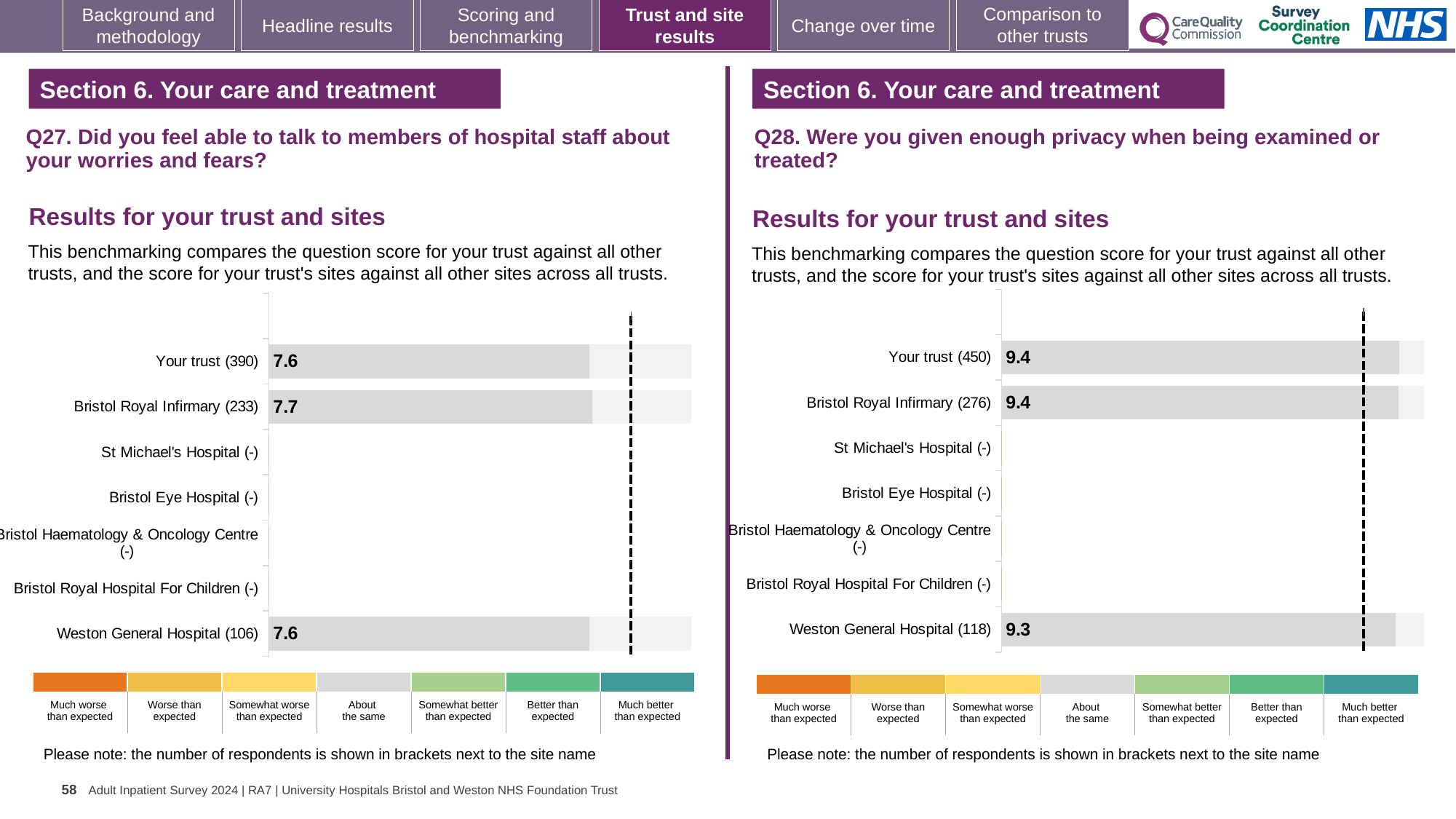
In the Q28 chart on the right, how many respondents are shown in brackets for Your trust? 450 In the Q27 chart on the left, how many respondents are shown in brackets for Weston General Hospital? 106 In the Q27 chart on the left, what is the score for Weston General Hospital? 7.6 In the Q28 chart on the right, what is the difference between the Bristol Royal Infirmary score and the Weston General Hospital score? 0.1 What kind of chart is used in the Q28 chart on the right? Bar chart In the Q28 chart on the right, what is the score for Your trust? 9.4 In the Q27 chart on the left, what is the score for Bristol Royal Infirmary? 7.7 In the Q28 chart on the right, what is the score for Weston General Hospital? 9.3 In the Q27 chart on the left, how many site or trust categories are listed on the vertical axis? 7 In the Q27 chart on the left, what is the difference between the Bristol Royal Infirmary score and the Your trust score? 0.1 In the Q27 chart on the left, what is the score for Your trust? 7.6 In the Q27 chart on the left, which site has a higher score: Bristol Royal Infirmary or Weston General Hospital? Bristol Royal Infirmary